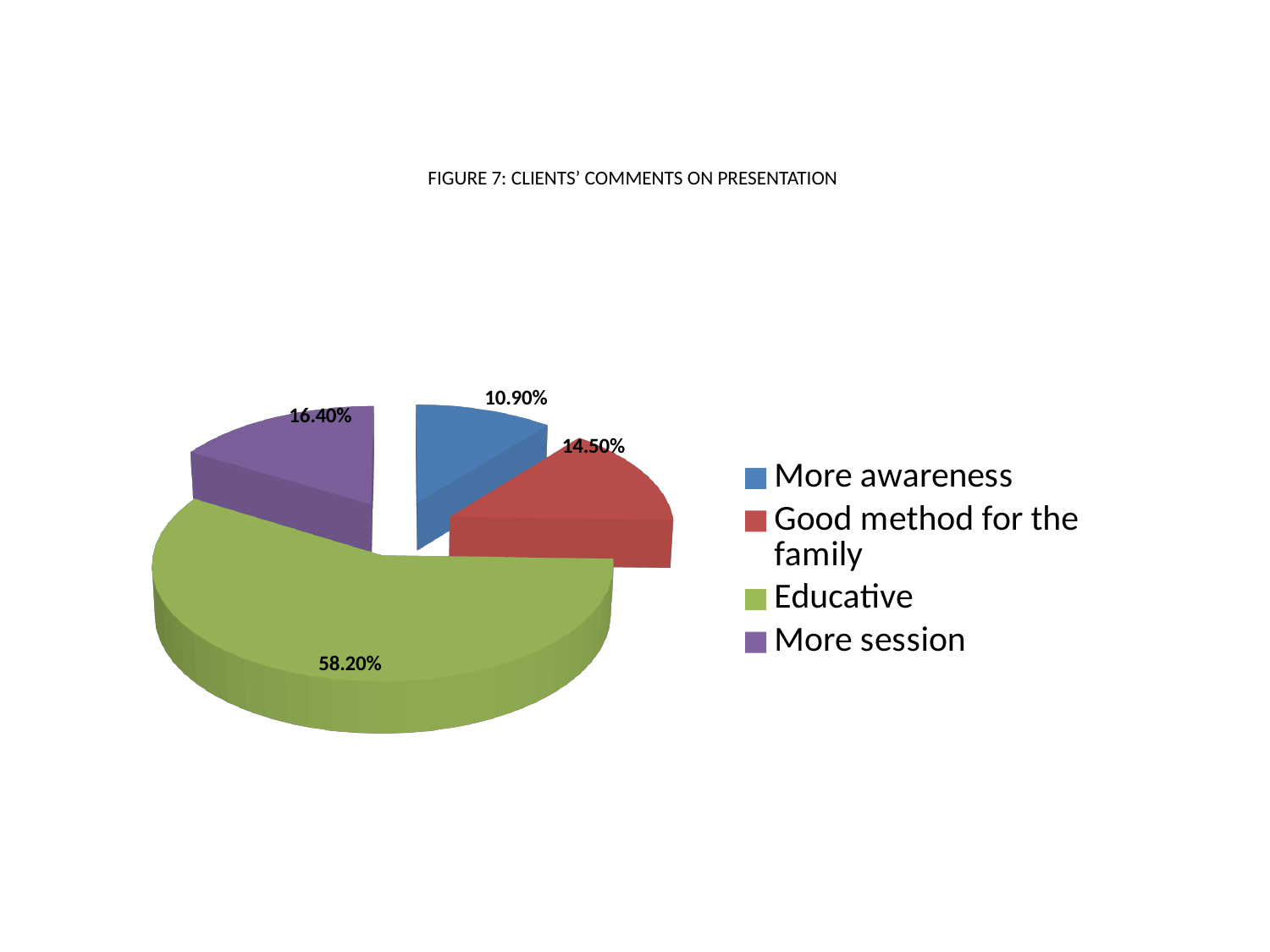
Which category has the largest share of the pie? Educative Which is larger, the value for Good method for the family or the value for More session? More session What is the value for More session? 16.40% What is the difference between the values for Educative and More session? 41.80% What type of chart is shown on the slide? Pie chart Which category has the smallest share of the pie? More awareness What is the value for More awareness? 10.90% What is the value for Good method for the family? 14.50% What is the value for Educative? 58.20% What is the title of the chart? FIGURE 7: CLIENTS' COMMENTS ON PRESENTATION How many categories does the pie chart show? 4 What is the difference between the values for More session and More awareness? 5.50%